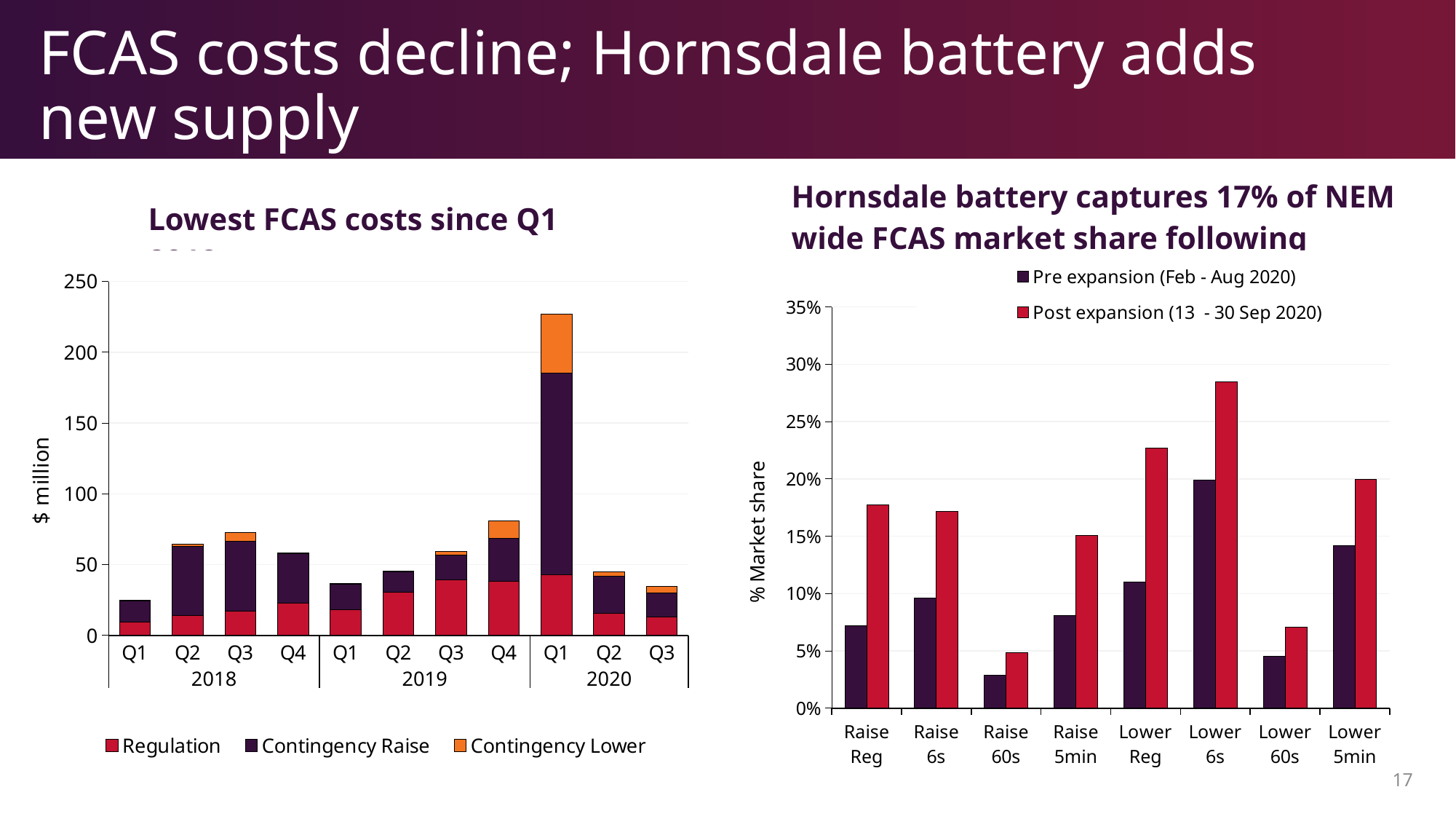
On the left chart (Lowest FCAS costs), what kind of chart is shown? Stacked bar chart On the left chart (Lowest FCAS costs), how many quarterly bars are plotted? 11 On the right chart (Hornsdale battery market share), how many FCAS categories are shown on the x axis? 8 On the left chart (Lowest FCAS costs), which quarter has the highest total FCAS cost? Q1 2020 On the right chart (Hornsdale battery market share), which category has the lowest pre expansion market share? Raise 60s On the right chart (Hornsdale battery market share), is the post expansion value for Lower 6s greater or less than 25%? greater On the left chart (Lowest FCAS costs), is the total for Q3 2020 greater or less than 50? less On the right chart (Hornsdale battery market share), how many series does the legend list? 2 On the left chart (Lowest FCAS costs), how many series does the legend list? 3 On the right chart (Hornsdale battery market share), which category has the highest post expansion market share? Lower 6s On the left chart (Lowest FCAS costs), is the total for Q1 2020 greater or less than 200? greater On the left chart (Lowest FCAS costs), what is the y-axis label? $ million